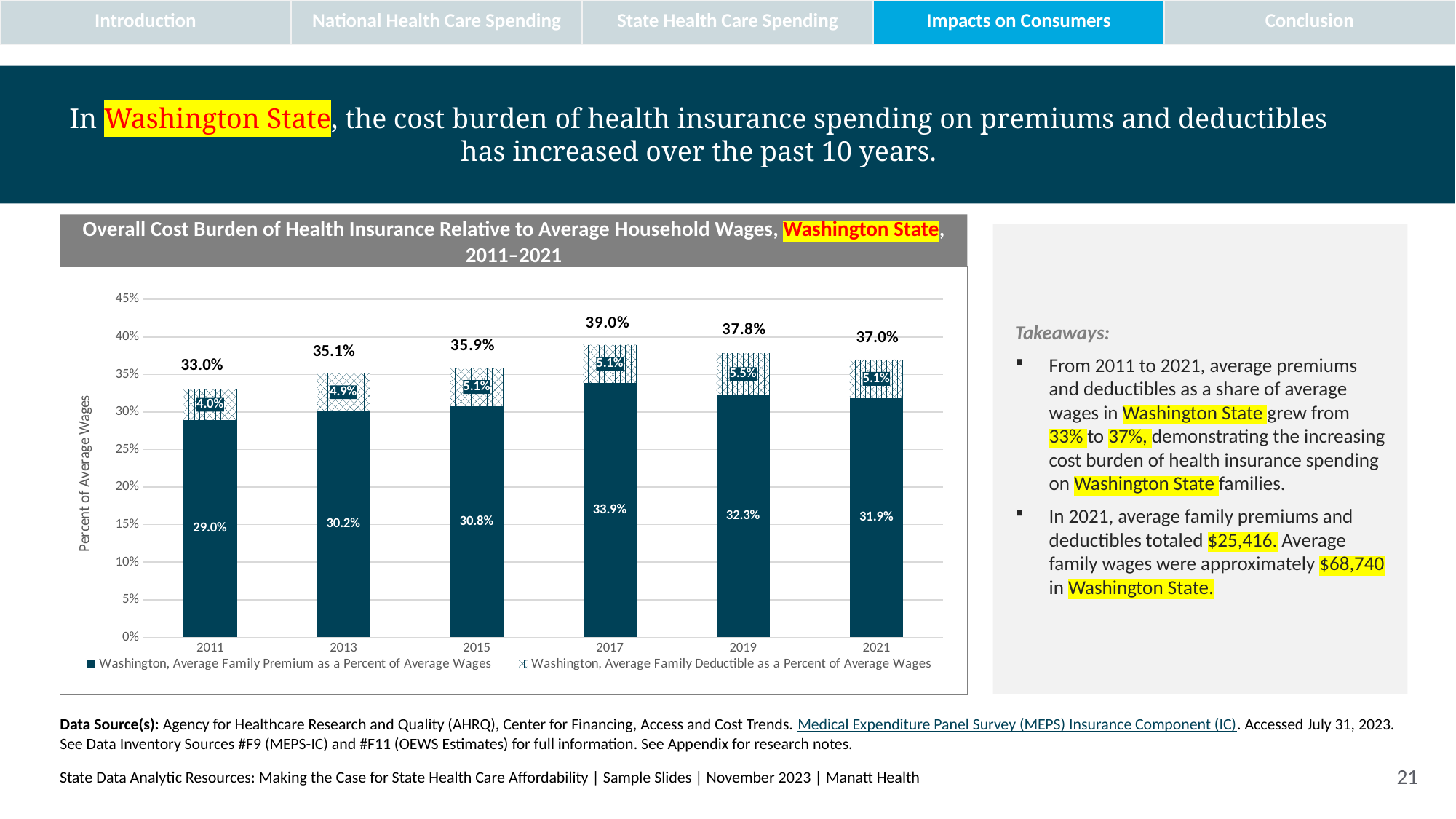
What is the label on the y axis of the chart? Percent of Average Wages What is the value for Washington, Average Family Premium as a Percent of Average Wages in 2011? 29.0% What is the difference between the total cost burden in 2021 and in 2011? 4.0% What is the total cost burden shown for 2017? 39.0% Which is larger, the premium share of wages in 2017 or in 2019? 2017 Is the total cost burden for 2013 greater or less than 40%? less What type of chart is shown on the slide? Stacked bar chart What is the value for Washington, Average Family Deductible as a Percent of Average Wages in 2019? 5.5% Which year has the lowest total cost burden? 2011 Which year has the highest total cost burden? 2017 How many years are shown on the x axis? 6 How many series does the legend list? 2